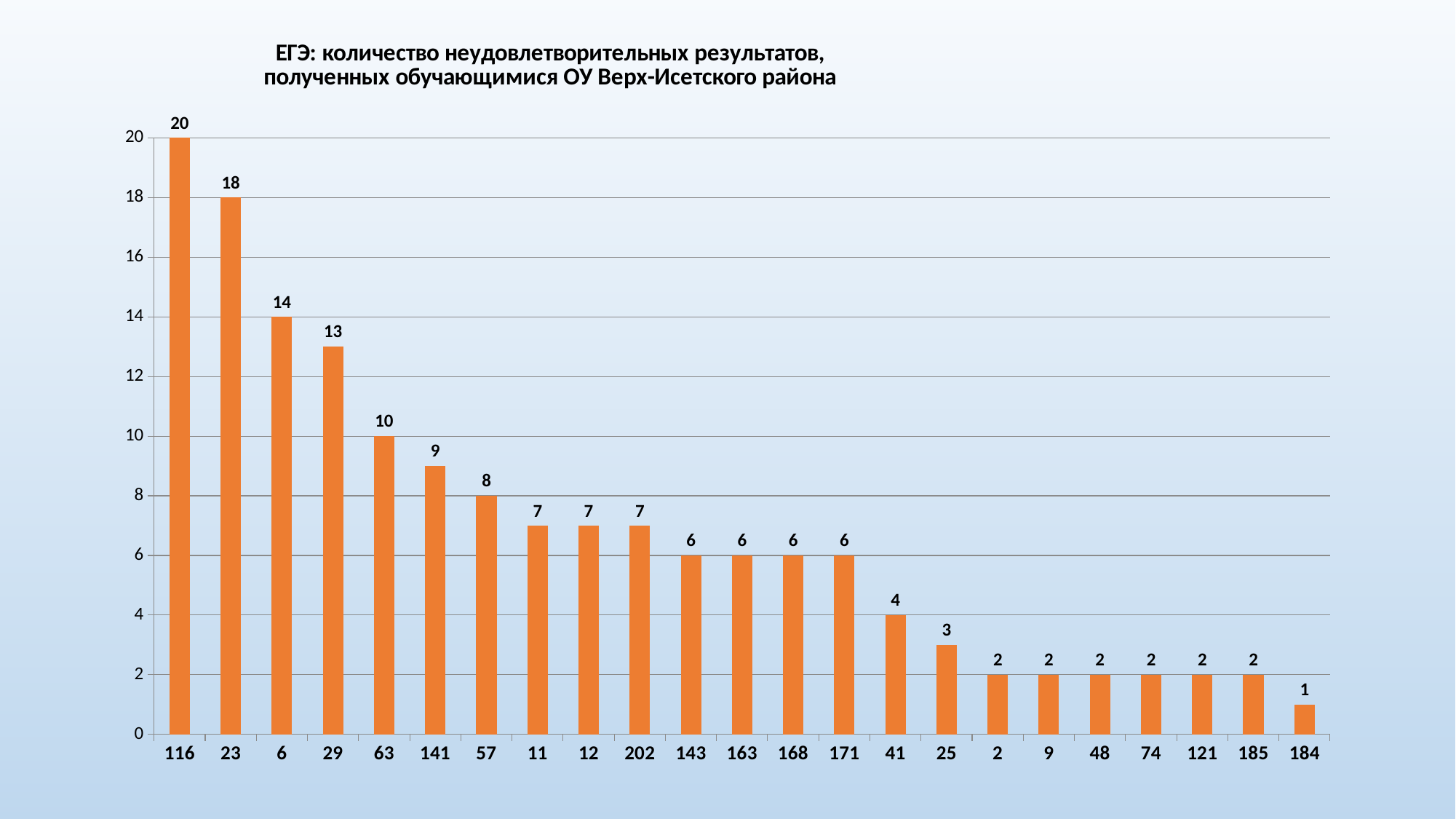
What is the difference between the values for school 23 and school 29? 5 What is the value for school 63? 10 What kind of chart is shown on the slide? bar chart Which school has the highest number of unsatisfactory results? 116 Is the value for school 141 greater or less than 10? less What is the value for school 41? 4 Which school has the lowest number of unsatisfactory results? 184 What is the value for school 116? 20 How many schools (categories) are shown on the x axis? 23 What colour are the bars in the chart? orange Which has a larger value, school 6 or school 57? 6 Do the values rise or fall from left to right along the x axis? fall